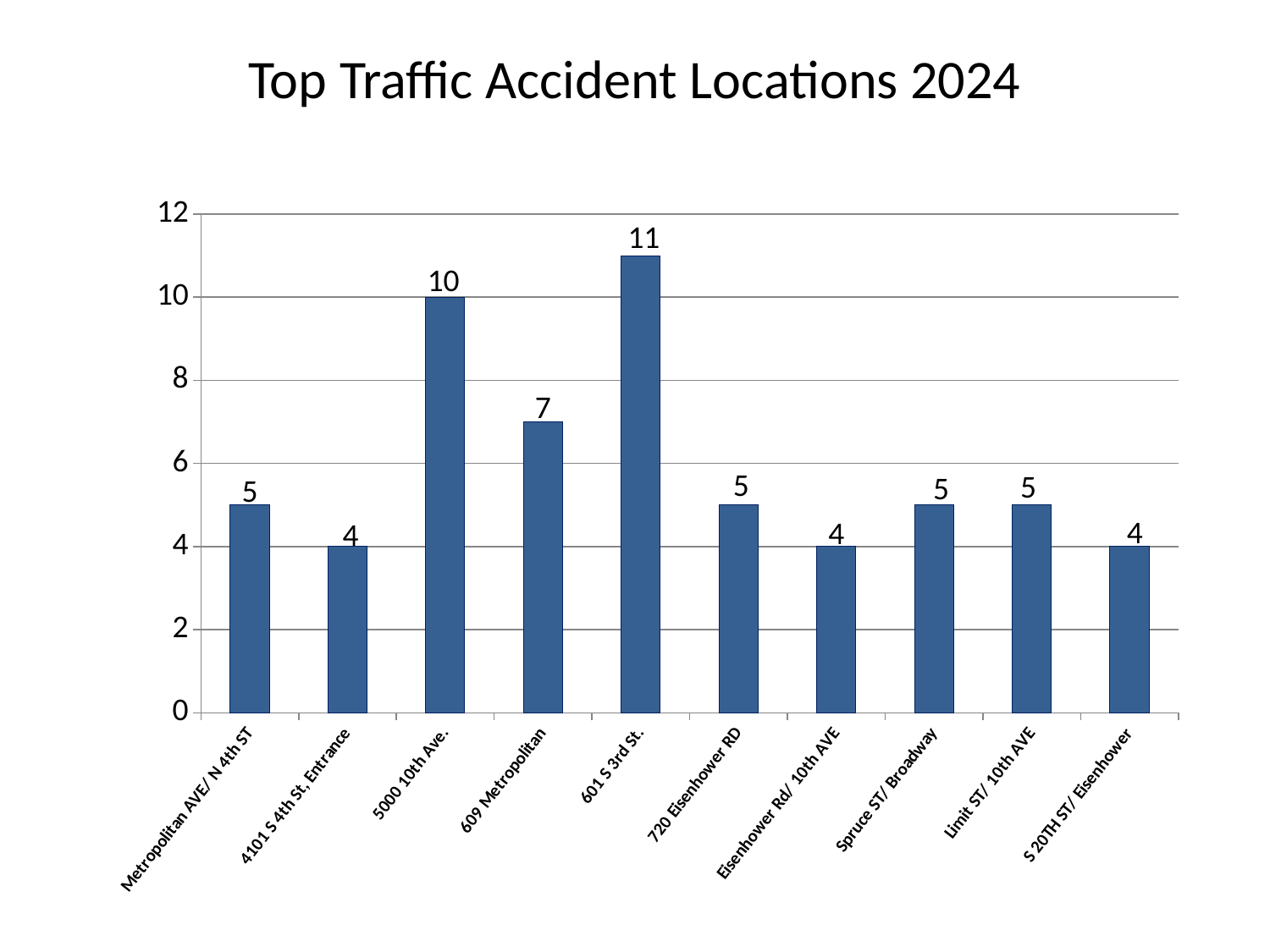
What is the value for 609 Metropolitan? 7 What is the value for 601 S 3rd St.? 11 Which is larger, the value for 609 Metropolitan or the value for 720 Eisenhower RD? 609 Metropolitan What is the difference between the values for 609 Metropolitan and 4101 S 4th St, Entrance? 3 What is the value for Eisenhower Rd/ 10th AVE? 4 What is the title of the chart? Top Traffic Accident Locations 2024 What kind of chart is shown on the slide? Bar chart How many locations are shown in the chart? 10 What is the value for 5000 10th Ave.? 10 Which location has the highest value? 601 S 3rd St. Is the value for 5000 10th Ave. greater or less than 8? greater What is the difference between the values for 601 S 3rd St. and 5000 10th Ave.? 1